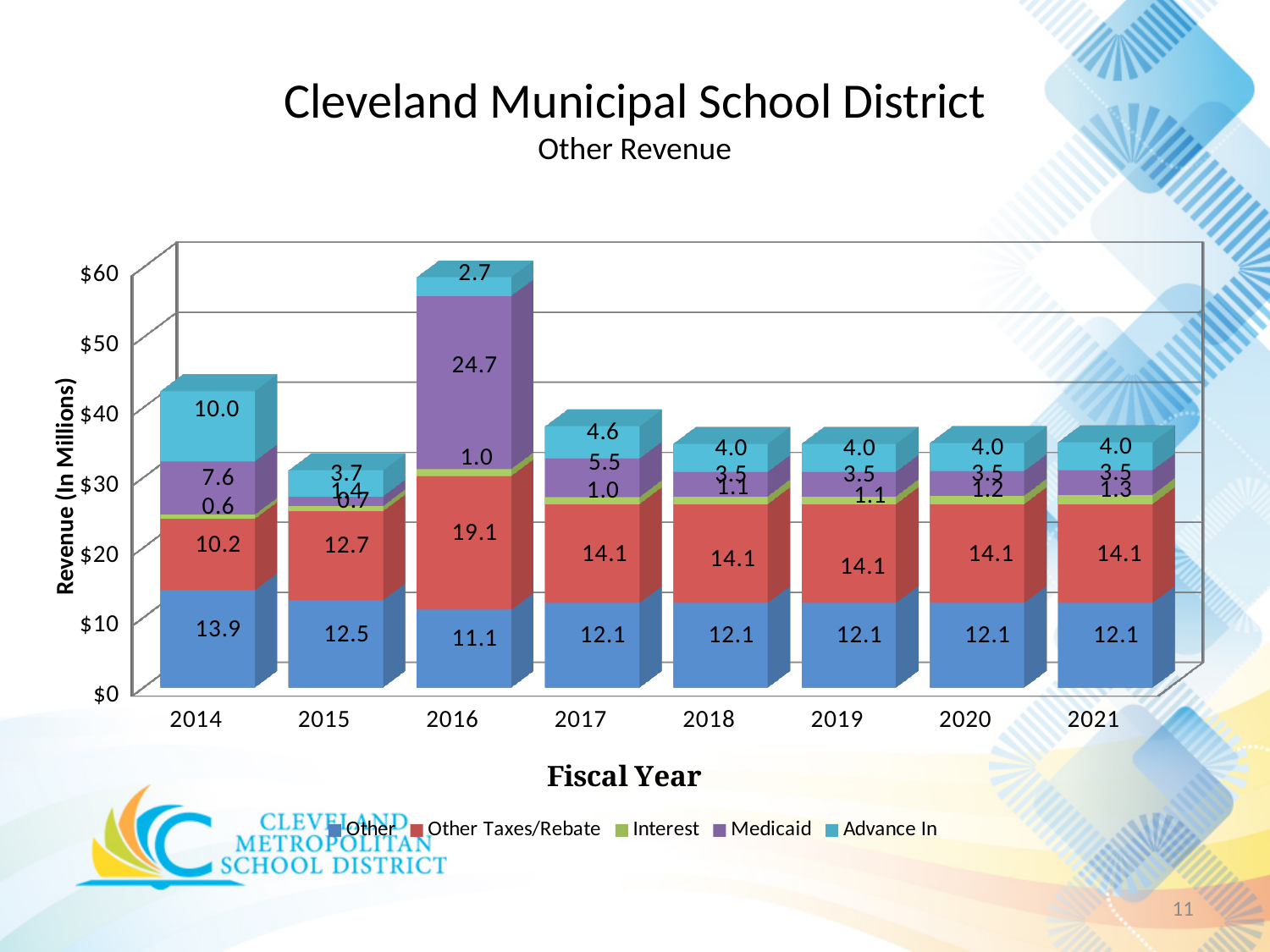
What is the Medicaid value for fiscal year 2016? 24.7 What is the Advance In value for fiscal year 2014? 10.0 How many fiscal years are shown on the x axis? 8 How many series does the legend list? 5 Which is larger, the Other value for 2014 or for 2015? 2014 What is the total of the stacked bar for fiscal year 2014? 42.3 What is the Other Taxes/Rebate value for fiscal year 2017? 14.1 Which fiscal year has the highest Medicaid value? 2016 What kind of chart is shown on the slide? Stacked bar chart What is the difference between the Other Taxes/Rebate values for 2016 and 2014? 8.9 Which fiscal year has the lowest value for the Other series? 2016 Is the total of the stacked bar for 2016 greater or less than $50? greater